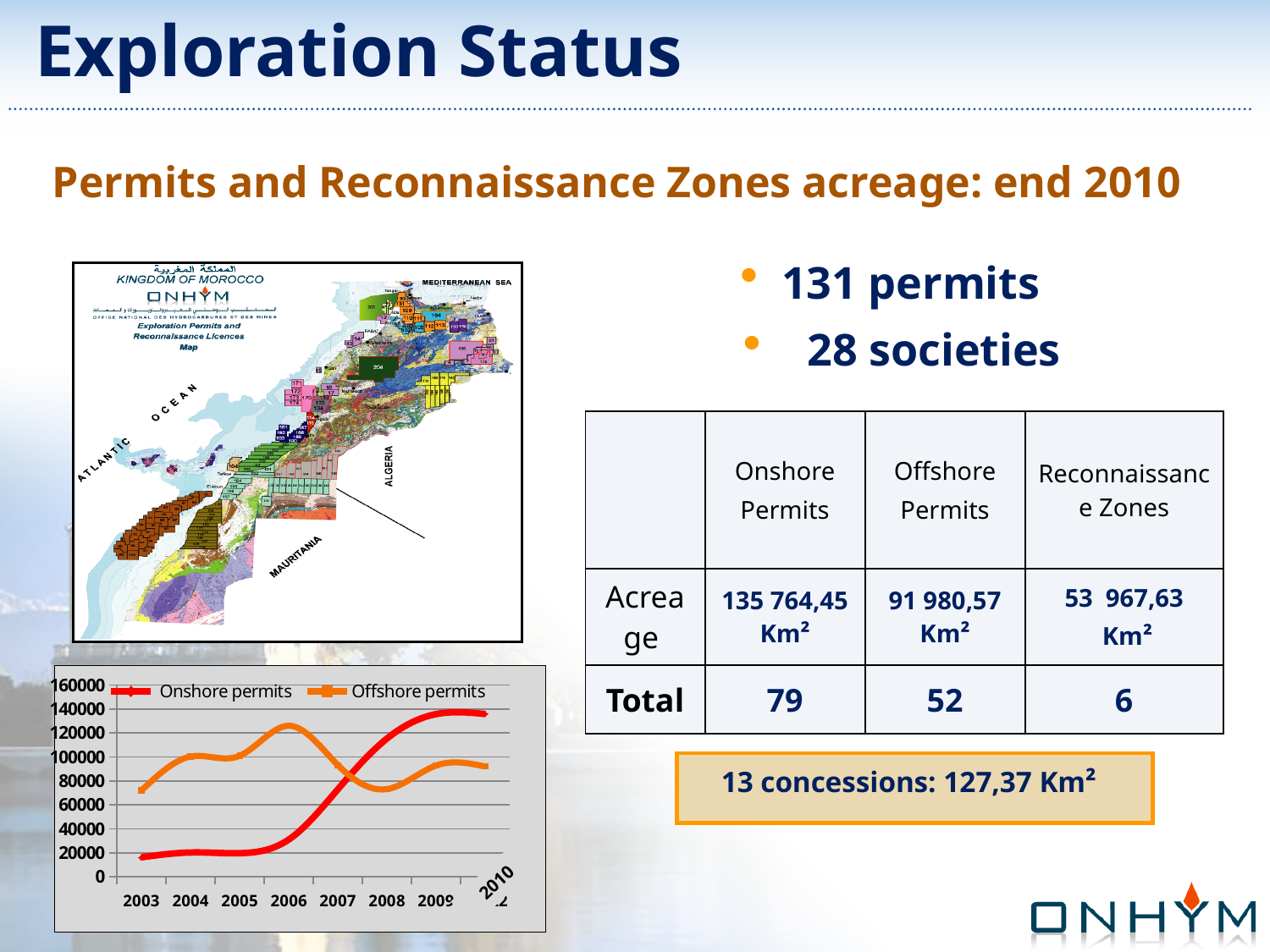
In the line chart, is the value for Offshore permits in 2006 greater or less than 100000? greater In the line chart, which series has the larger value in 2003, Onshore permits or Offshore permits? Offshore permits In the line chart, is the value for Onshore permits in 2007 greater or less than 100000? less In the line chart, do the Onshore permits values rise or fall from 2003 to 2009? rise In the line chart, in which year does the Offshore permits series reach its highest value? 2006 How many years are shown on the x axis of the line chart? 8 In the line chart, is the value for Onshore permits in 2003 greater or less than 20000? less How many series does the legend of the line chart list? 2 In the line chart, what colour is the Onshore permits line? red In the line chart, which series has the larger value in 2009, Onshore permits or Offshore permits? Onshore permits What kind of chart is shown at the bottom left of the slide? line chart